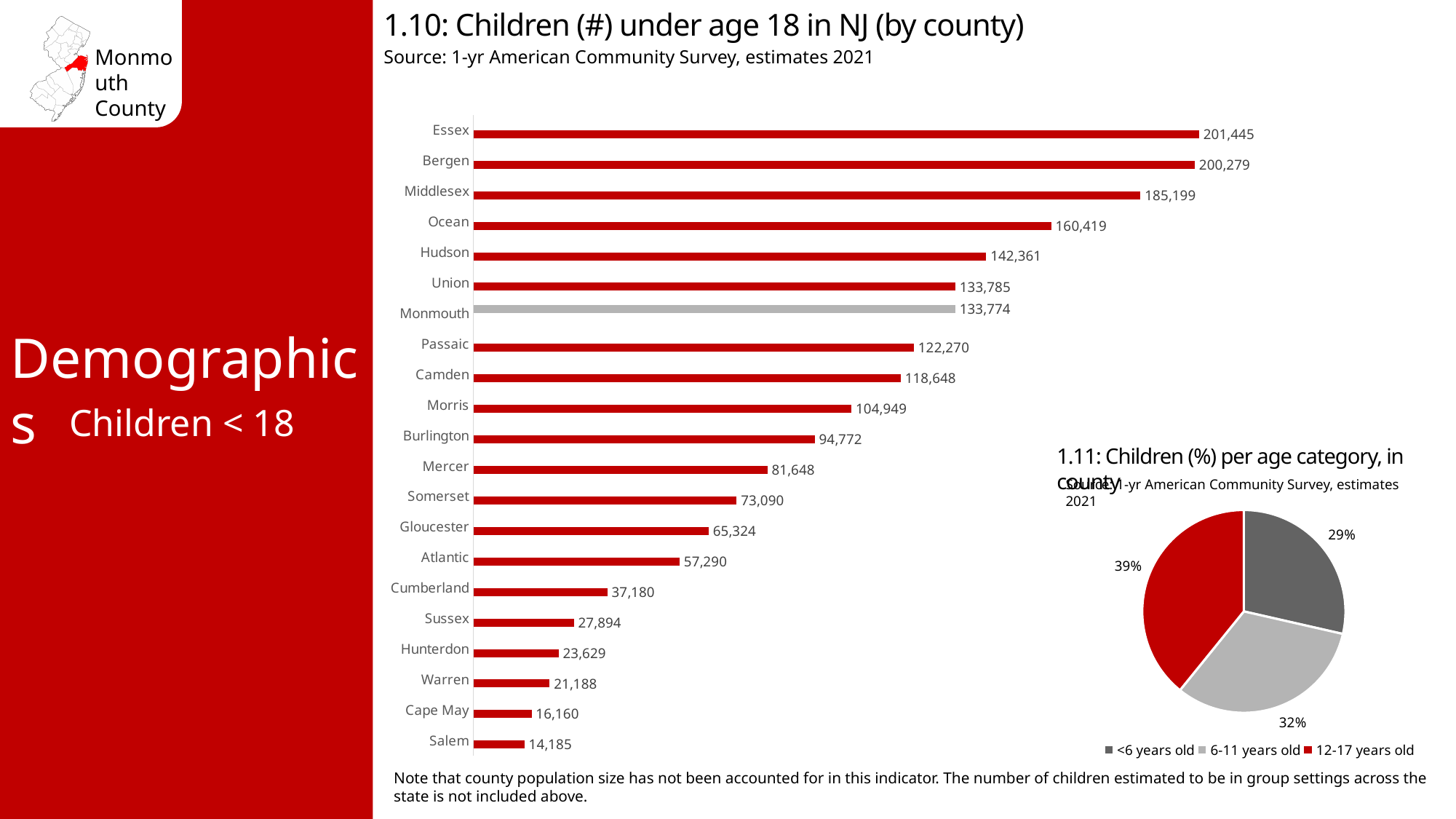
In chart 1.10, what is the value for Ocean County? 160,419 In chart 1.10, how many counties are shown? 21 In chart 1.10, which county has more children under 18, Passaic or Camden? Passaic In chart 1.10, which county has the lowest number of children under 18? Salem In chart 1.10, which bar is shown in grey instead of red? Monmouth What type of chart is chart 1.10? Bar chart In chart 1.10, what is the difference between the values for Essex and Bergen? 1,166 In chart 1.11 (Children (%) per age category, in county), what share of children are 12-17 years old? 39% In chart 1.10 (Children under age 18 in NJ by county), how many children under 18 are in Monmouth County? 133,774 In chart 1.10, which county has the highest number of children under 18? Essex In chart 1.11, which age category has the smallest share? <6 years old How many categories does the legend of chart 1.11 list? 3